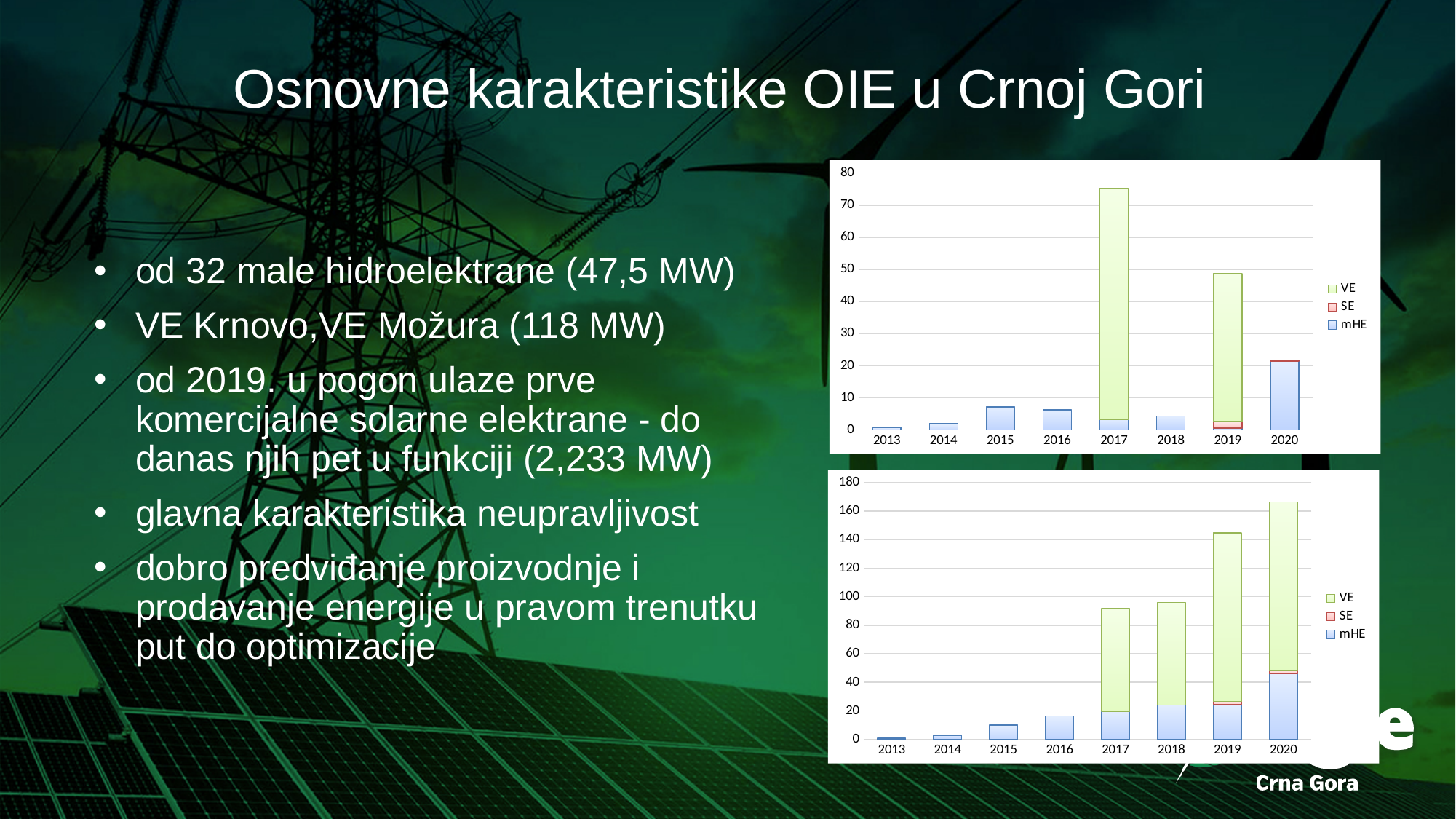
In the top chart, is the total value for 2020 greater or less than 30? less What are the legend entries of the top chart? VE, SE, mHE In the bottom chart, is the total value for 2018 greater or less than 100? less In the bottom chart, is the total value for 2020 greater or less than 160? greater In the bottom chart, which year has the tallest stacked bar? 2020 In the bottom chart, do the total values rise or fall from 2013 to 2020? rise How many years are shown on the x axis of the top chart? 8 In the top chart, which year has the tallest stacked bar? 2017 How many series does the legend of the bottom chart list? 3 What kind of chart is the top chart on the slide? stacked bar chart In the top chart, which year has the shortest stacked bar? 2013